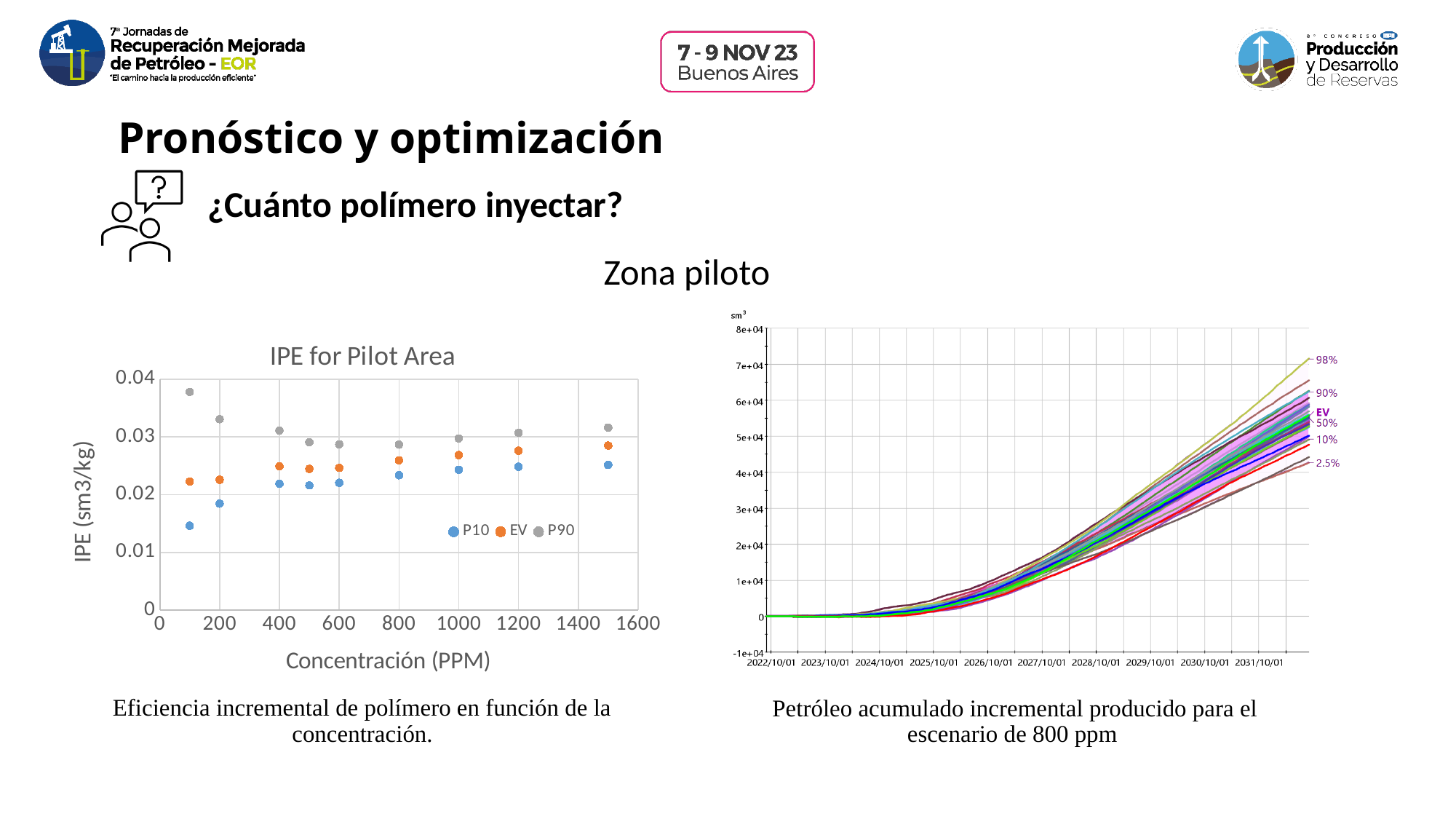
What kind of chart is the 'IPE for Pilot Area' chart? Scatter chart In the 'IPE for Pilot Area' chart, which is larger at 200 PPM, the P90 value or the P10 value? P90 In the 'IPE for Pilot Area' chart, how many series does the legend list? 3 What is the title of the chart on the left of the slide? IPE for Pilot Area In the 'IPE for Pilot Area' chart, do the P10 values generally rise or fall as concentration increases? rise In the 'IPE for Pilot Area' chart, is the P10 value at 1500 PPM greater or less than 0.02? greater In the 'IPE for Pilot Area' chart, at which concentration is the P90 value highest? 100 PPM In the 'IPE for Pilot Area' chart, is the P90 value at 100 PPM greater or less than 0.03? greater In the chart on the right of the slide (cumulative incremental oil for the 800 ppm scenario), is the 2.5% curve at the end of the period greater or less than 5e+04 sm3? less In the 'IPE for Pilot Area' chart, how many data points are plotted for the P90 series? 9 In the 'IPE for Pilot Area' chart, at which concentration is the P10 value lowest? 100 PPM